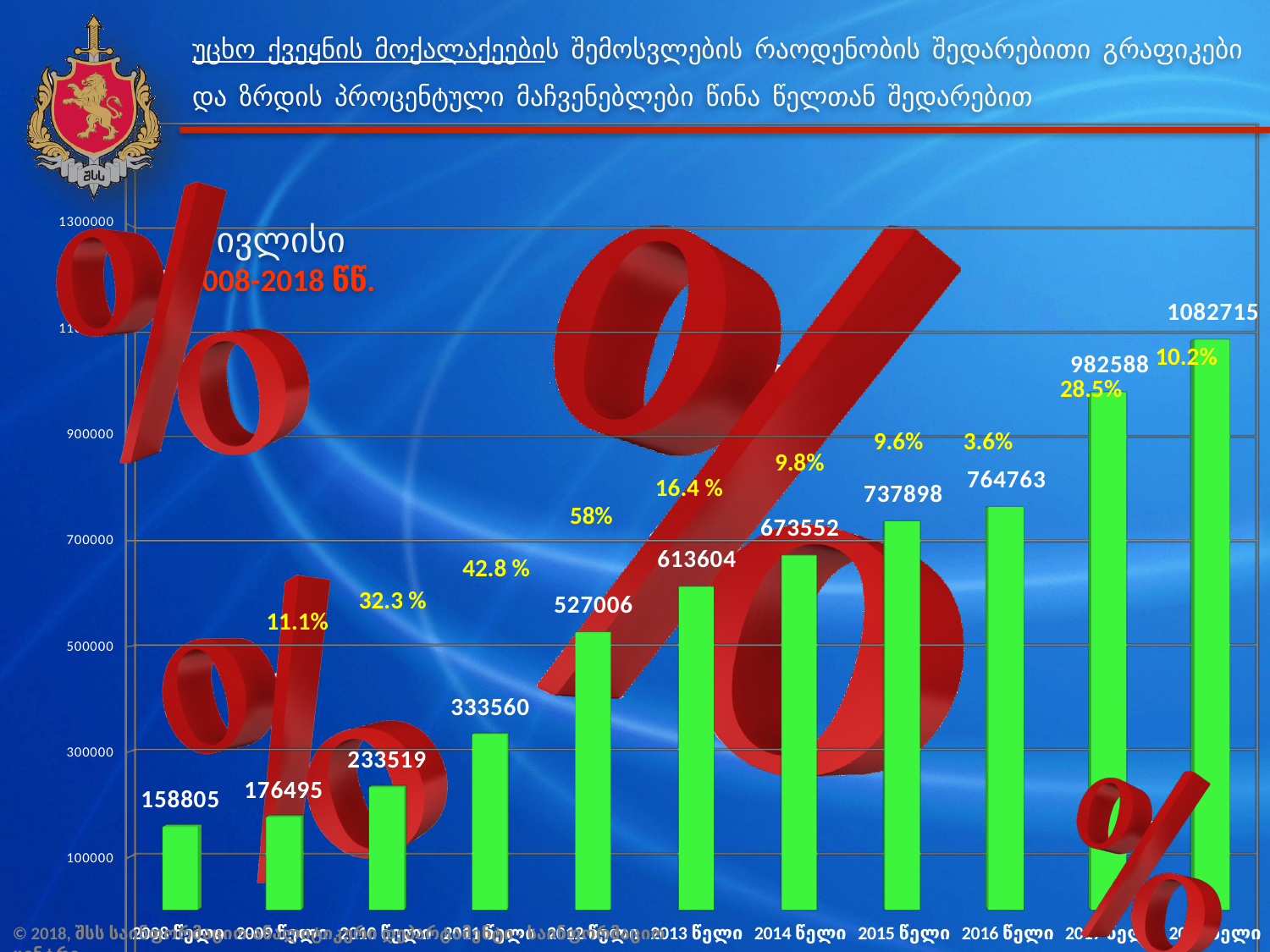
Is the value for 2011 წელი greater or less than 300000? greater How many bars are shown in the chart? 11 What is the value for 2016 წელი? 764763 What is the difference between the values for 2009 წელი and 2008 წელი? 17690 What is the difference between the values for 2018 წელი and 2017 წელი? 100127 Which is larger, the value for 2013 წელი or 2014 წელი? 2014 წელი Which year has the highest value? 2018 წელი What is the value for 2012 წელი? 527006 Do the bar values rise or fall from 2008 to 2018? rise What kind of chart is shown on the slide? bar chart What is the value for 2008 წელი? 158805 Which year has the lowest value? 2008 წელი